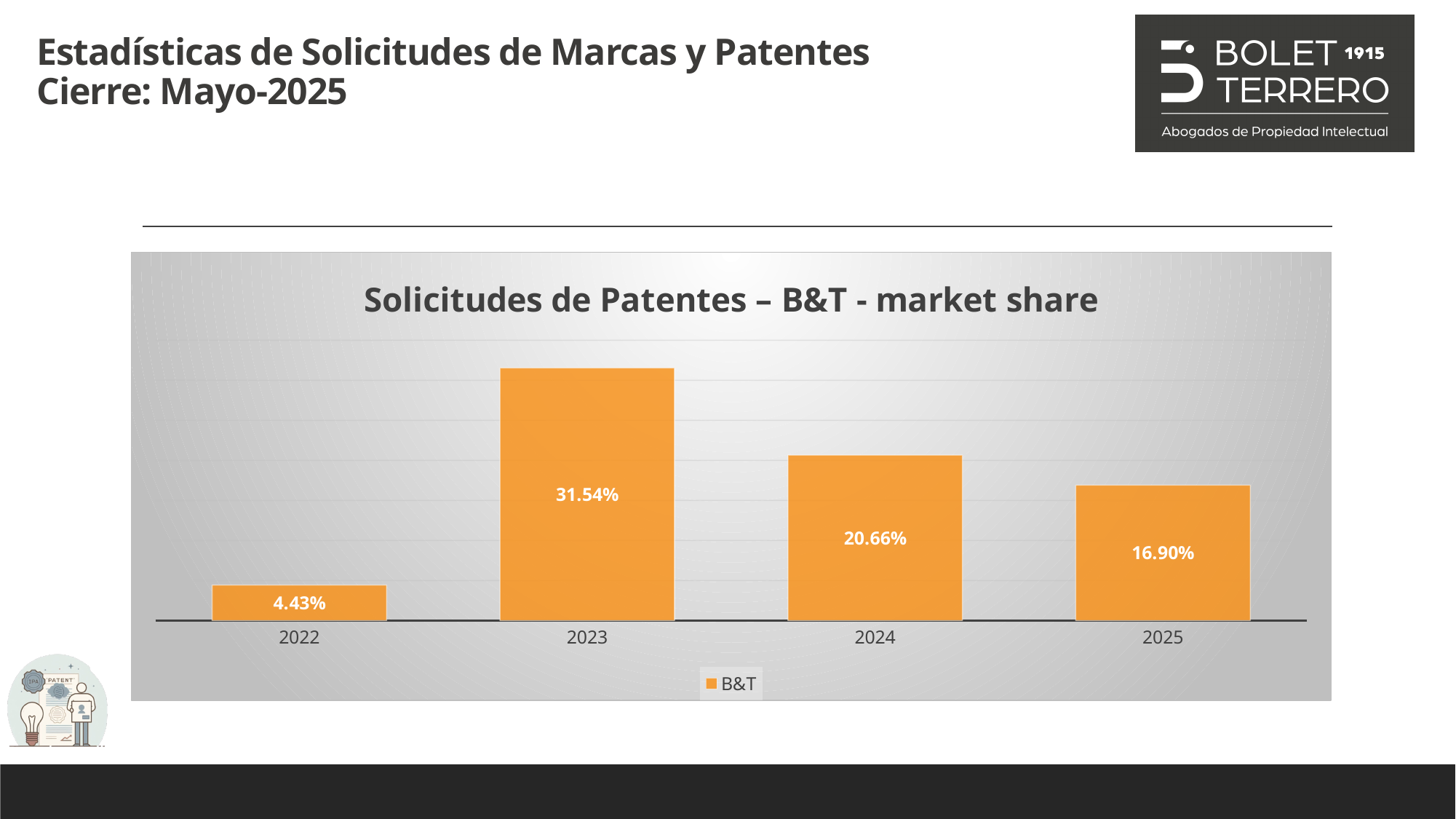
Which year has the lowest B&T market share? 2022 Which year has the highest B&T market share? 2023 What is the title of the chart? Solicitudes de Patentes – B&T - market share What is the difference between the 2023 and 2024 market share values? 10.88% What is the difference between the 2024 and 2025 market share values? 3.76% What is the B&T market share value for 2025? 16.90% What kind of chart is shown on the slide? Bar chart What is the B&T market share value for 2022? 4.43% How many series does the legend list? 1 Which year has a larger market share, 2024 or 2025? 2024 How many years are shown on the x axis of the chart? 4 What is the B&T market share value for 2023? 31.54%